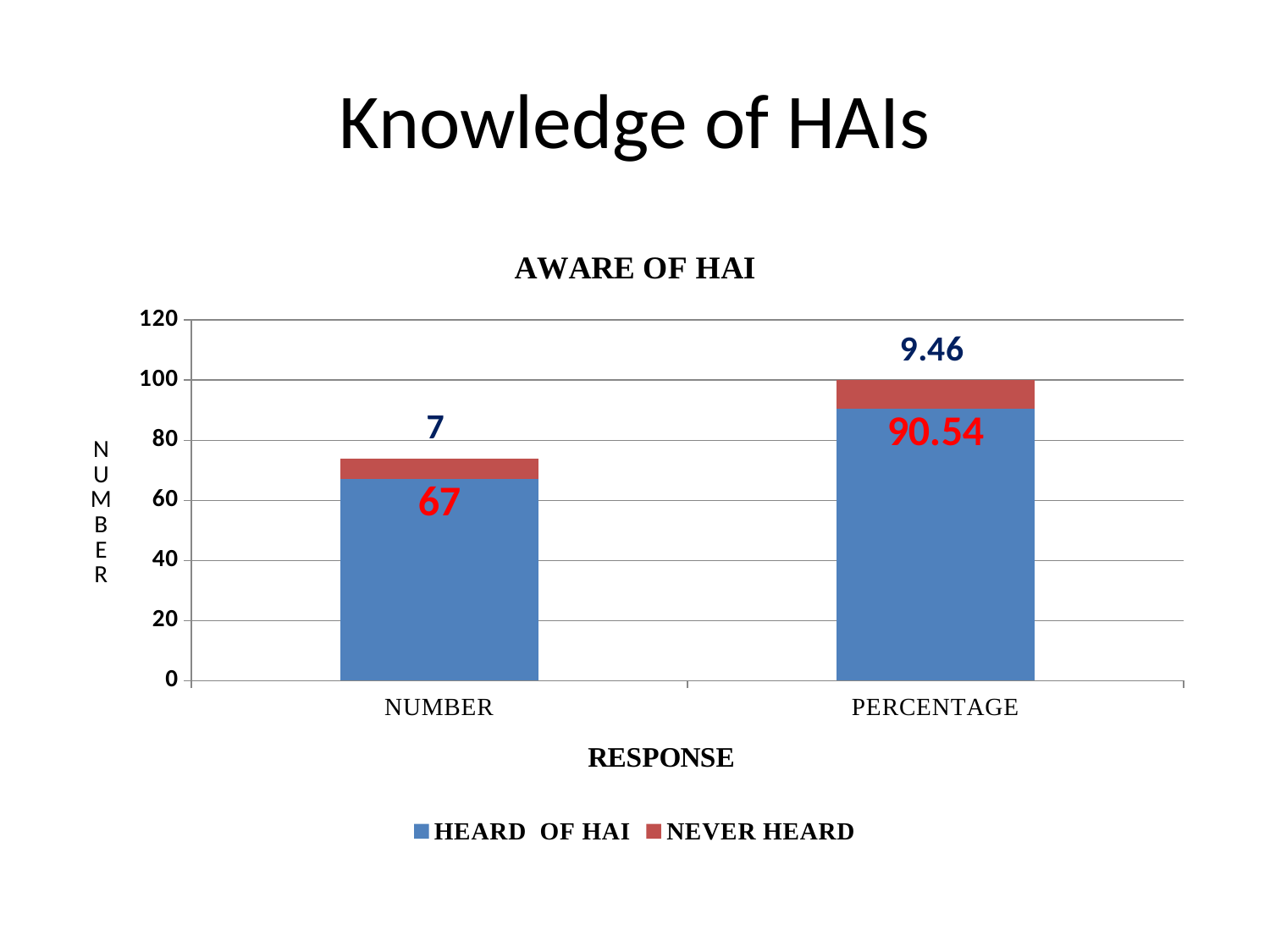
What is the value for HEARD OF HAI in the PERCENTAGE category? 90.54 What is the value for HEARD OF HAI in the NUMBER category? 67 What is the value for NEVER HEARD in the NUMBER category? 7 Which is larger in the PERCENTAGE category, HEARD OF HAI or NEVER HEARD? HEARD OF HAI What is the total of the stacked bar for NUMBER? 74 How many categories are shown on the x axis? 2 What is the value for NEVER HEARD in the PERCENTAGE category? 9.46 What is the total of the stacked bar for PERCENTAGE? 100 How many series does the legend list? 2 What is the difference between the HEARD OF HAI and NEVER HEARD values in the NUMBER category? 60 What is the title of the chart? AWARE OF HAI What kind of chart is shown? Stacked bar chart